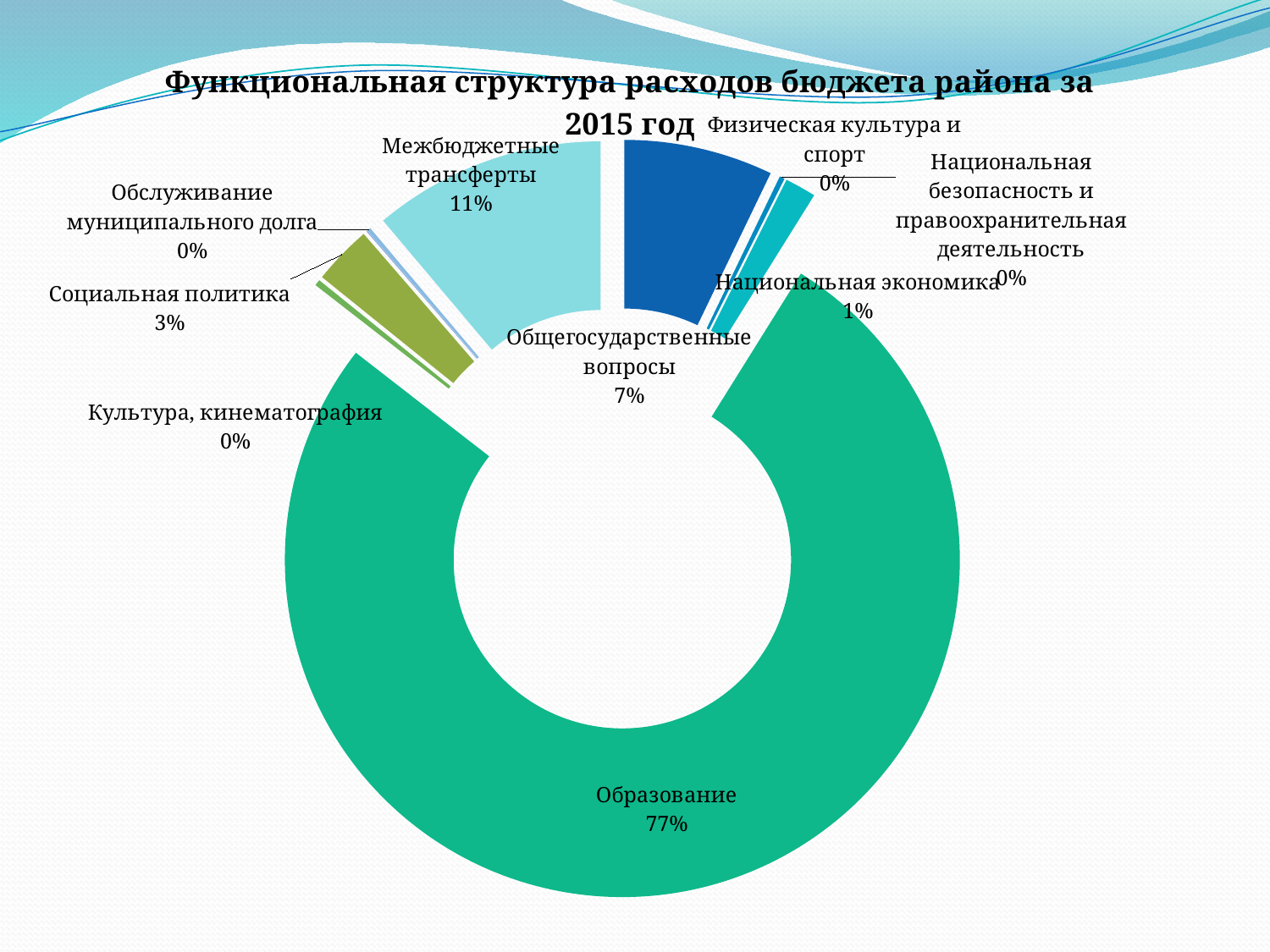
What share is shown for Межбюджетные трансферты? 11% What is the difference in percentage points between Образование and Межбюджетные трансферты? 66 percentage points What is the title of the chart? Функциональная структура расходов бюджета района за 2015 год What share is shown for Социальная политика? 3% What share of expenditure is labelled for Образование? 77% What kind of chart is shown on the slide? Doughnut (pie) chart Which is larger, the share for Межбюджетные трансферты or for Общегосударственные вопросы? Межбюджетные трансферты What share is shown for Культура, кинематография? 0% What share is shown for Общегосударственные вопросы? 7% What share is shown for Национальная экономика? 1% How many categories are labelled on the chart? 9 Which category has the largest share of the budget expenditure? Образование